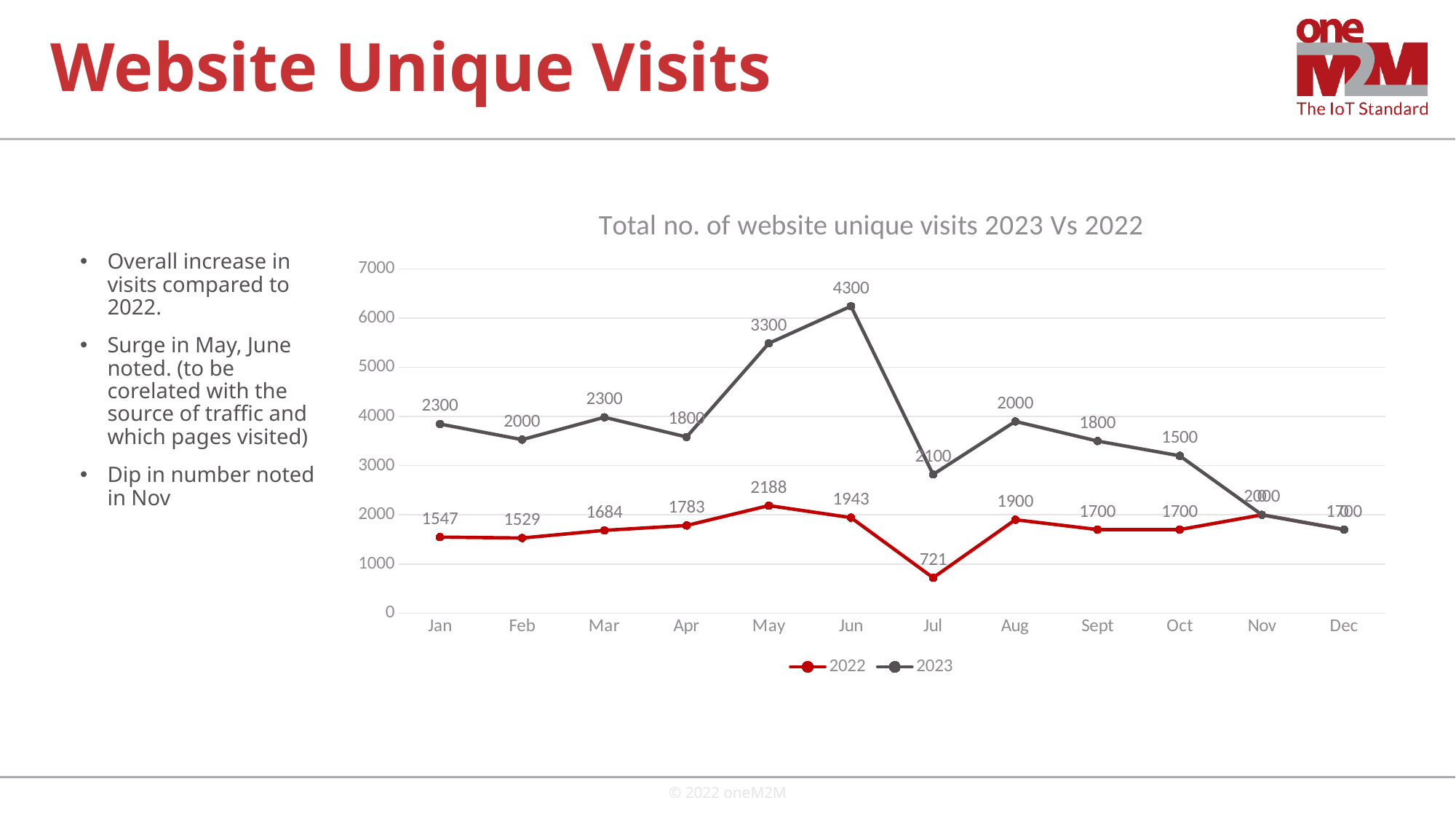
What is the value for 2022 in July? 721 Do the 2022 values rise or fall from January to April? Rise Which is larger in January, the 2022 value or the 2023 value? 2023 What is the value for 2023 in June? 4300 What is the difference between the 2023 and 2022 values in June? 2112 In which month is the 2023 value highest? Jun What is the value for 2022 in May? 2188 In which month is the 2022 value lowest? Jul How many series does the legend list? 2 How many months are plotted along the x axis? 12 What is the title of the chart? Total no. of website unique visits 2023 Vs 2022 What type of chart is shown on the slide? Line chart